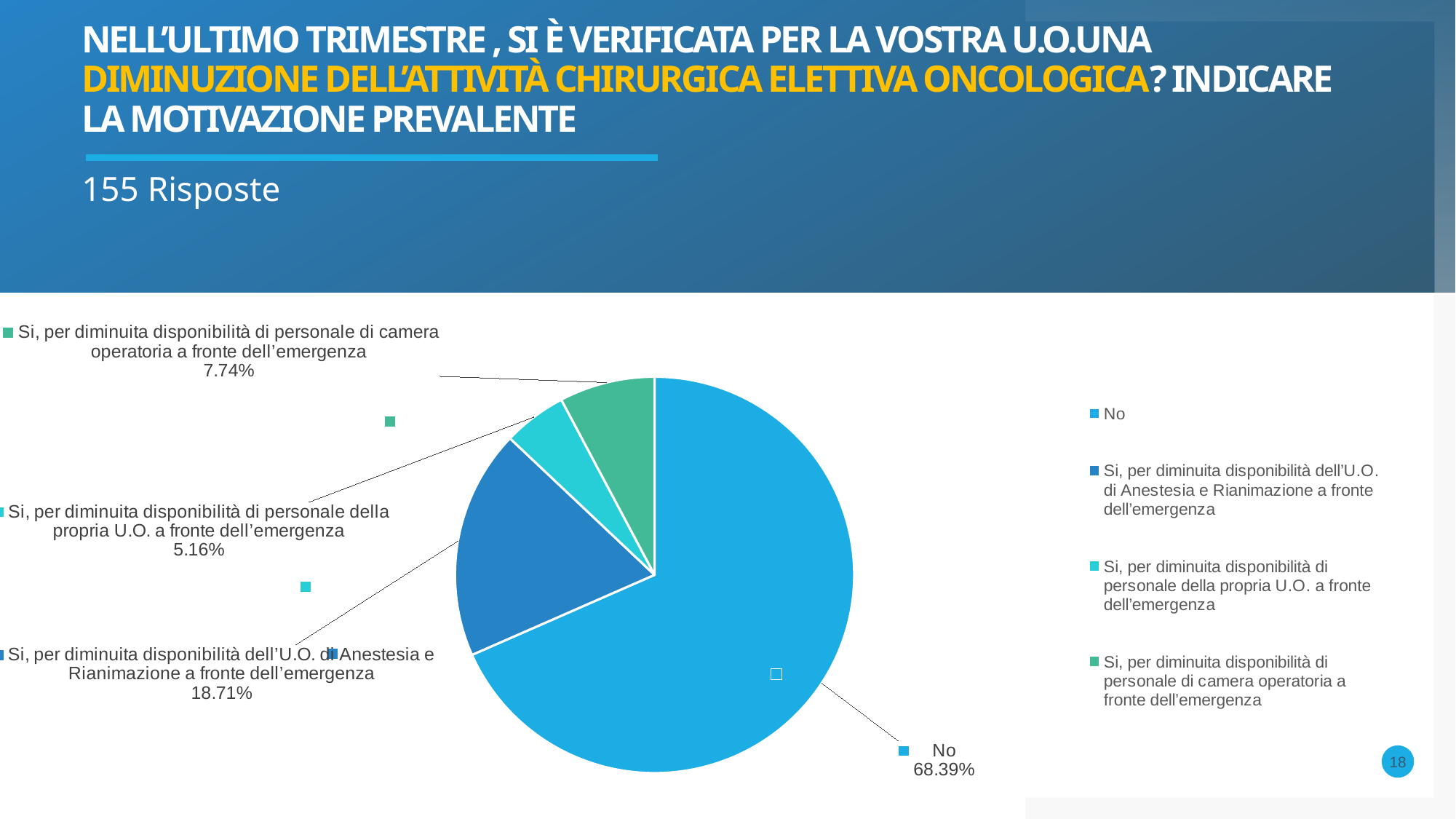
What type of chart is shown on the slide? Pie chart Which category has the largest slice of the pie? No How many responses does the slide say the chart is based on? 155 Risposte What percentage is shown for "Si, per diminuita disponibilità di personale della propria U.O. a fronte dell'emergenza"? 5.16% Which category has the smallest slice of the pie? Si, per diminuita disponibilità di personale della propria U.O. a fronte dell'emergenza What share of the pie does the "No" slice represent? 68.39% What percentage is shown for "Si, per diminuita disponibilità di personale di camera operatoria a fronte dell'emergenza"? 7.74% How many entries does the legend list? 4 Which is larger: the slice for "personale di camera operatoria" or the slice for "personale della propria U.O."? Si, per diminuita disponibilità di personale di camera operatoria a fronte dell'emergenza What is the difference in percentage points between the "No" slice and the "Anestesia e Rianimazione" slice? 49.68 How many slices does the pie chart have? 4 What percentage is shown for "Si, per diminuita disponibilità dell'U.O. di Anestesia e Rianimazione a fronte dell'emergenza"? 18.71%